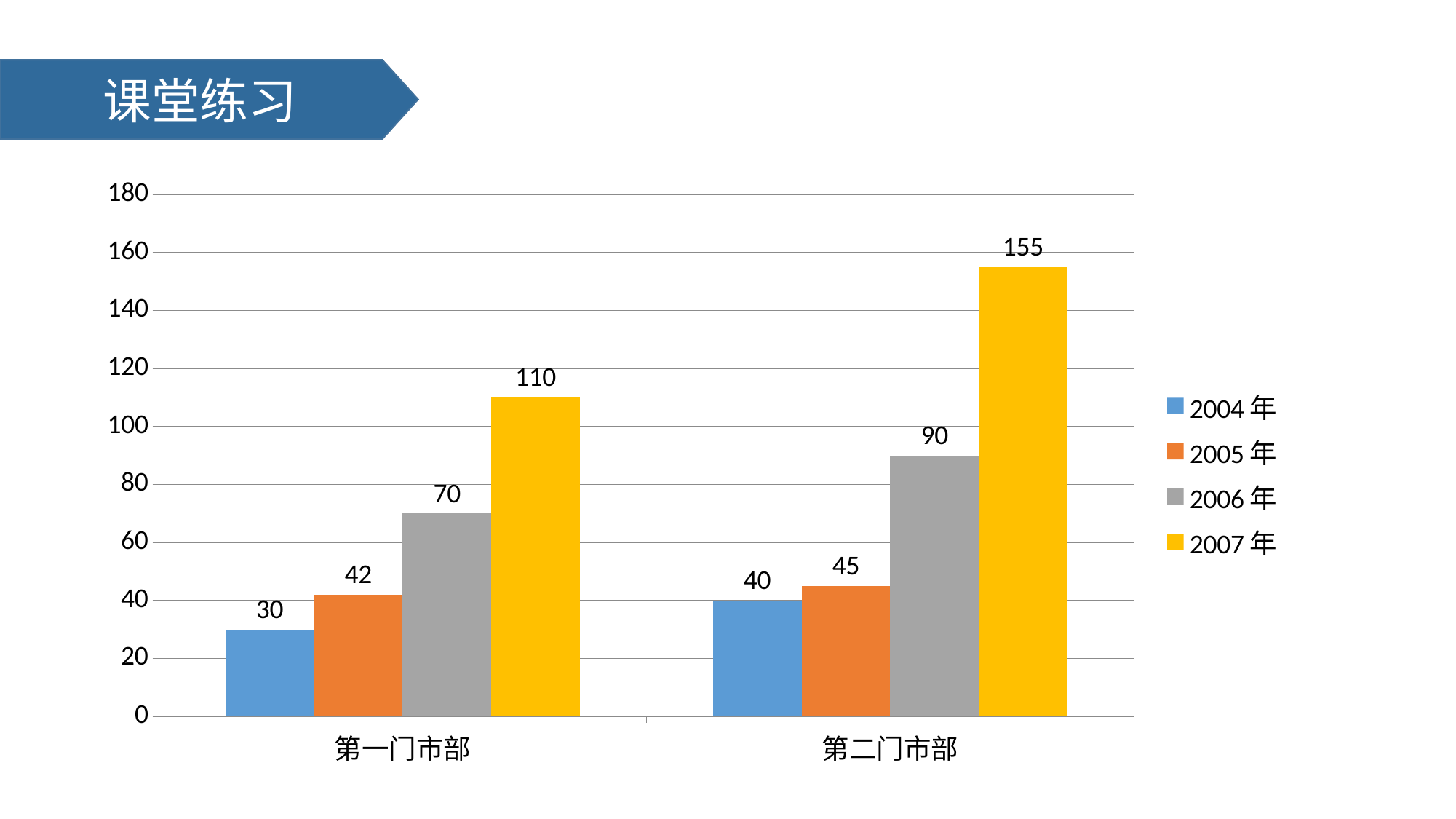
Is the value for 2007年 at 第二门市部 greater or less than 140? greater What is the value for 2007年 at 第一门市部? 110 How many categories are shown on the x axis? 2 Which is larger, the 2006年 value for 第一门市部 or for 第二门市部? 第二门市部 Which series has the lowest value at 第一门市部? 2004年 Which colour represents 2006年 in the legend? grey What is the difference between the 2007年 values for 第二门市部 and 第一门市部? 45 What is the value for 2005年 at 第二门市部? 45 How many series does the legend list? 4 What kind of chart is shown on the slide? bar chart What is the value for 2004年 at 第一门市部? 30 Which series has the highest value at 第二门市部? 2007年